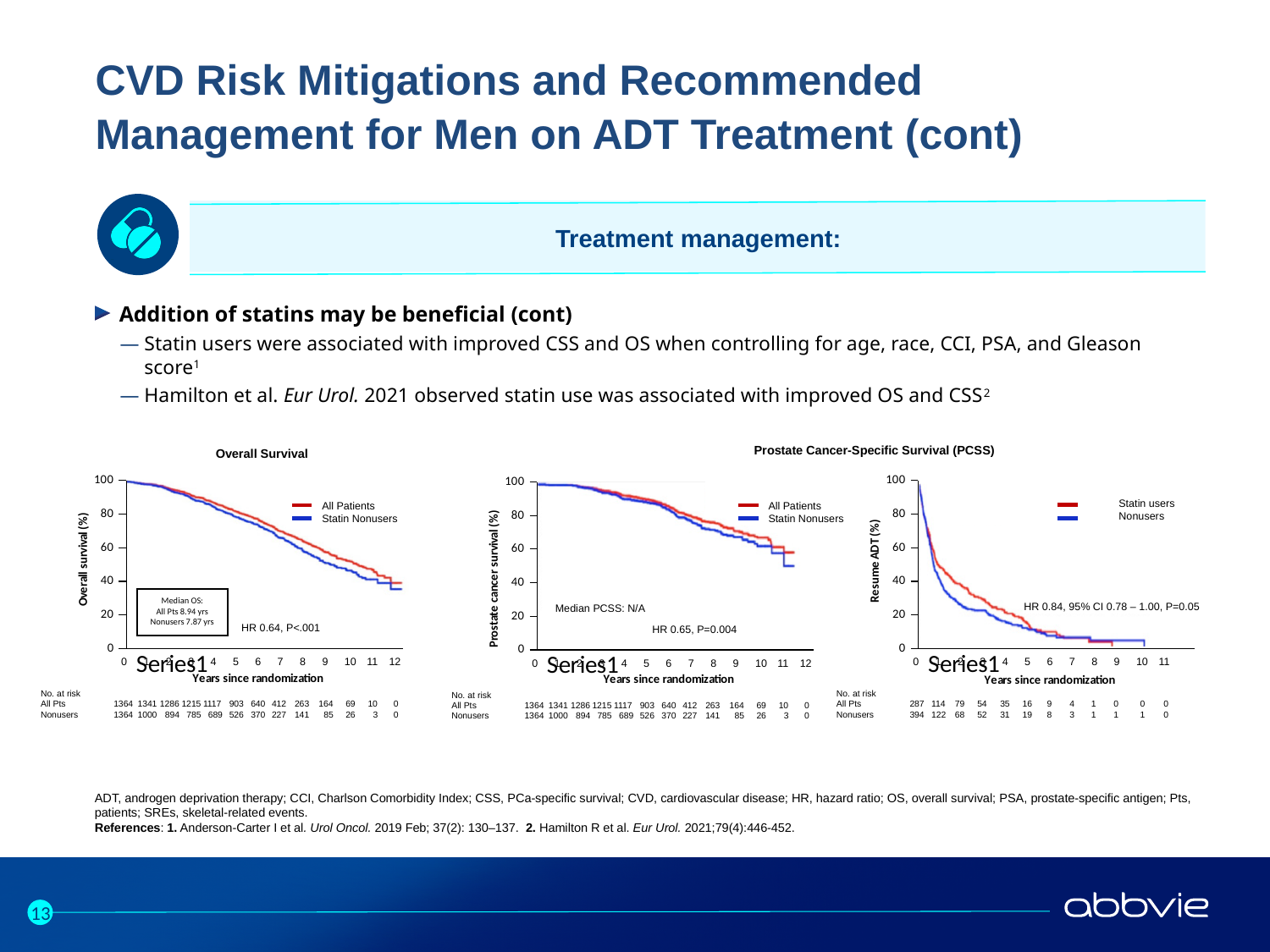
In the Overall Survival chart, how many patients are at risk in the All Pts row at year 0? 1364 In the Overall Survival chart, what hazard ratio is printed on the plot? HR 0.64, P<.001 In the rightmost chart (Resume ADT), is the value for Nonusers at year 2 greater or less than 40? less In the Overall Survival chart, do the survival curves rise or fall as years since randomization increase? Fall In the rightmost chart (Resume ADT), what hazard ratio, confidence interval and P value are printed? HR 0.84, 95% CI 0.78 – 1.00, P=0.05 In the Overall Survival chart, what is the median OS for all patients shown in the annotation box? 8.94 yrs What are the two legend entries in the Overall Survival chart? All Patients and Statin Nonusers In the Overall Survival chart, which curve is higher over most of the follow-up, All Patients or Statin Nonusers? All Patients What kind of chart is the Overall Survival chart? Line chart (Kaplan-Meier survival curve) In the Prostate Cancer-Specific Survival (PCSS) chart (middle), what hazard ratio and P value are printed on the plot? HR 0.65, P=0.004 How many series does the legend of the Overall Survival chart list? 2 In the Overall Survival chart, what is the median OS for nonusers shown in the annotation box? 7.87 yrs